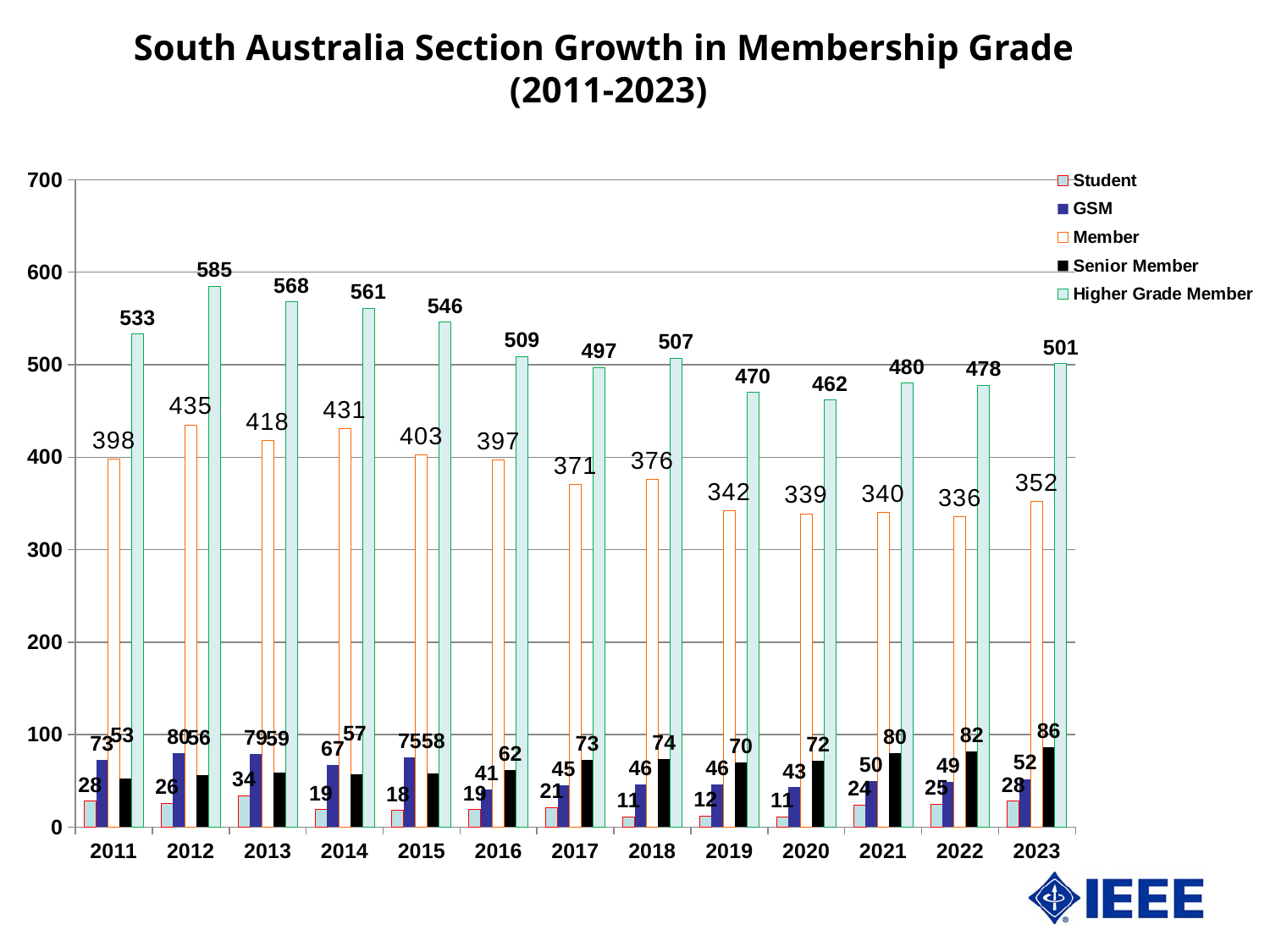
In which year is the Member value lowest? 2022 What is the difference between the Member value in 2011 and in 2023? 46 What is the title of the chart? South Australia Section Growth in Membership Grade (2011-2023) In which year is the Senior Member value highest? 2023 How many years are shown on the x axis? 13 What is the value for Member in 2012? 435 What kind of chart is shown on the slide? Bar chart In which year is the Higher Grade Member value highest? 2012 How many series does the legend list? 5 What is the value for Student in 2018? 11 Which is larger, the Member value in 2014 or in 2015? 2014 What is the value for Higher Grade Member in 2023? 501